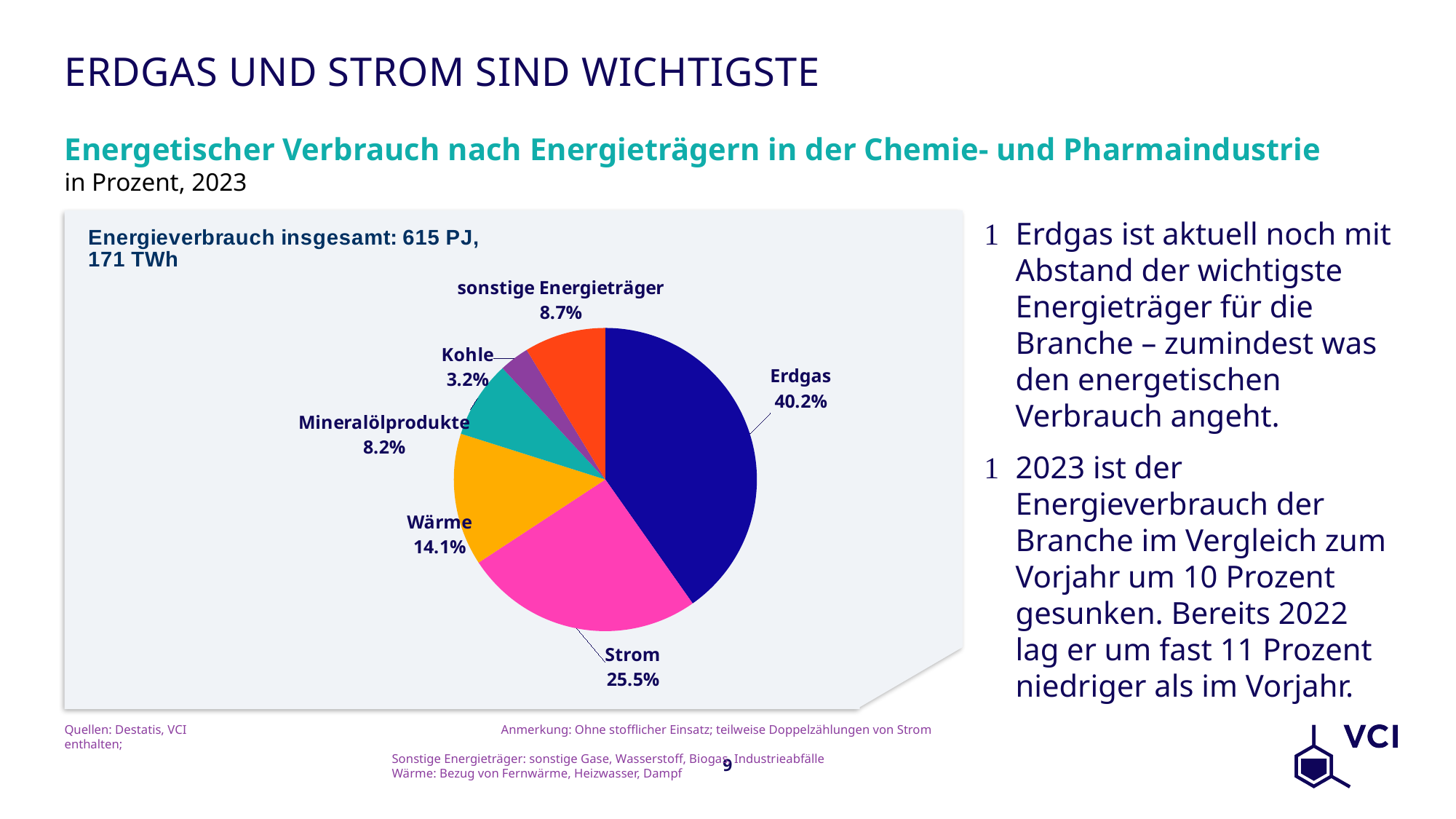
What share is shown for sonstige Energieträger? 8.7% How many slices does the pie chart have? 6 What is the difference in percentage points between Erdgas and Strom? 14.7 What is the value shown for Strom? 25.5% What total energy consumption is stated in the chart box? 615 PJ, 171 TWh What is the value for Kohle? 3.2% Which energy source has the largest slice of the pie? Erdgas What type of chart is shown on the slide? pie chart What percentage is shown for Wärme? 14.1% Which is larger, the share for Mineralölprodukte or the share for sonstige Energieträger? sonstige Energieträger Which energy source has the smallest slice of the pie? Kohle What share of energy consumption does Erdgas account for? 40.2%